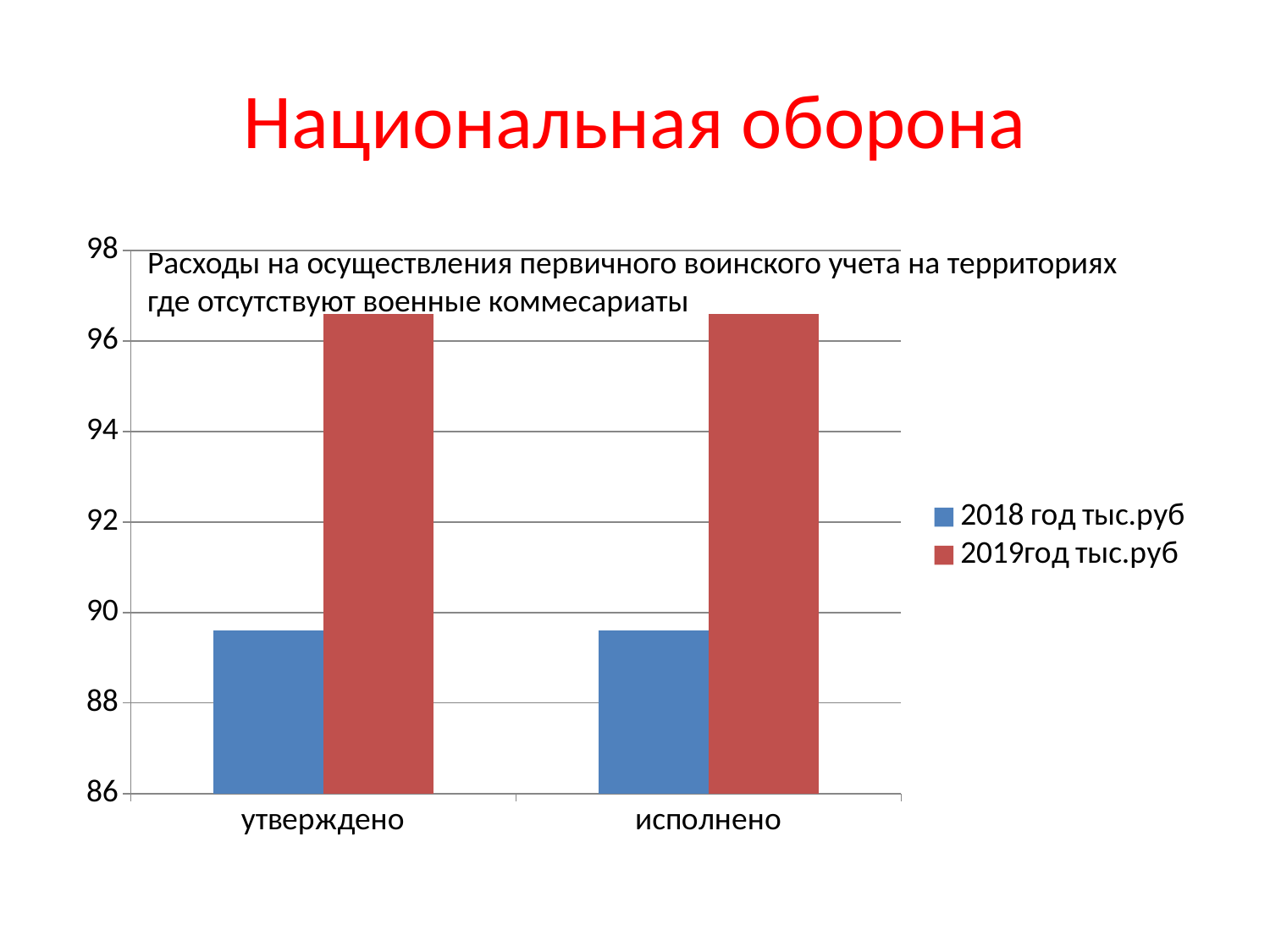
How many categories are shown on the x axis of the chart? 2 What is the title of the slide? Национальная оборона Is the value for 2018 год тыс.руб in the исполнено category greater or less than 90? less How many series does the chart legend list? 2 In the исполнено category, which series has the larger value: 2018 год тыс.руб or 2019год тыс.руб? 2019год тыс.руб Is the value for 2019год тыс.руб in the исполнено category greater or less than 96? greater What kind of chart is shown on the slide? bar chart Is the value for 2018 год тыс.руб in the утверждено category greater or less than 90? less In the утверждено category, which series has the larger value: 2018 год тыс.руб or 2019год тыс.руб? 2019год тыс.руб Which colour represents the 2019год тыс.руб series in the chart? red